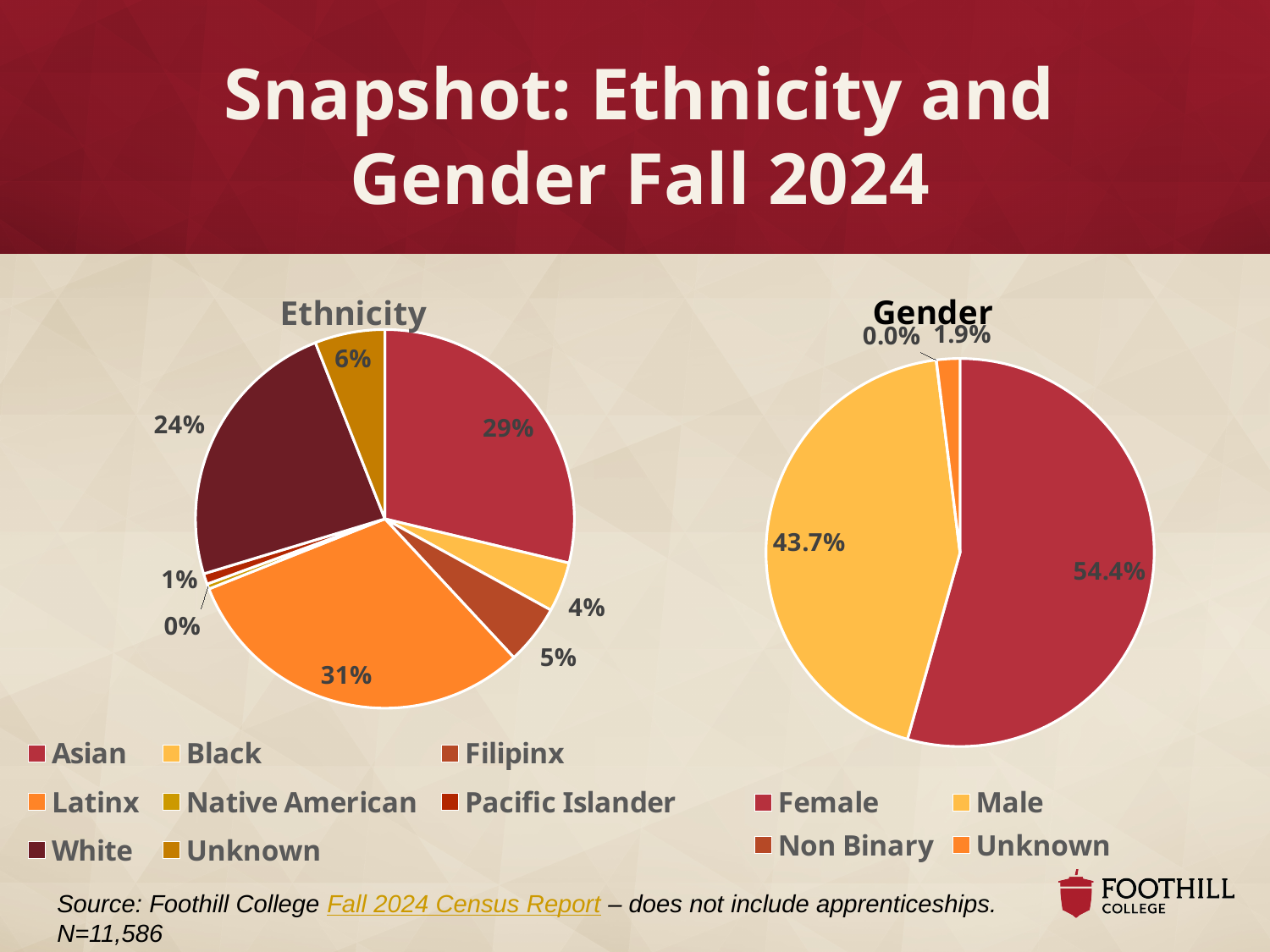
In the Gender pie chart, what percentage is shown for Unknown? 1.9% In the Ethnicity pie chart, what is the difference between the Latinx and Asian percentages? 2 percentage points In the Ethnicity pie chart, what percentage is shown for White? 24% In the Gender pie chart, what percentage is shown for Female? 54.4% In the Ethnicity pie chart, what percentage is shown for Asian? 29% In the Ethnicity pie chart, which is larger, Filipinx or Black? Filipinx In the Gender pie chart, what is the difference between the Female and Male percentages? 10.7 percentage points How many categories does the Ethnicity pie chart's legend list? 8 In the Ethnicity pie chart, which category has the largest share? Latinx In the Ethnicity pie chart, what percentage is shown for Latinx? 31% In the Gender pie chart, what percentage is shown for Male? 43.7% What kind of chart is the Gender chart? Pie chart